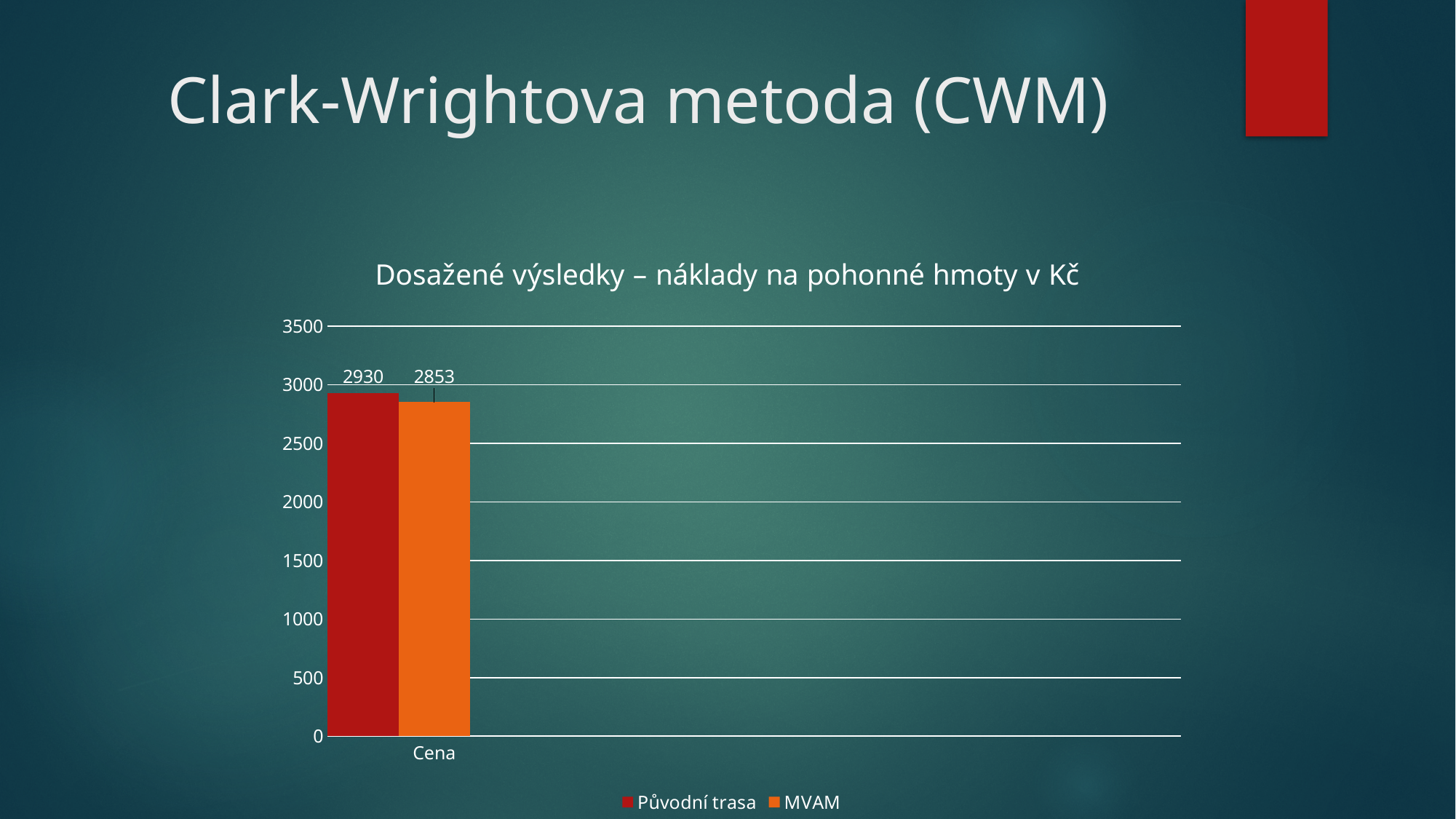
Is the value for Původní trasa greater or less than 2500? greater Which series has the higher value, Původní trasa or MVAM? Původní trasa Is the value for MVAM greater or less than 3000? less What is the label of the category on the x axis? Cena What is the title of the chart? Dosažené výsledky – náklady na pohonné hmoty v Kč What is the difference between the Původní trasa value and the MVAM value? 77 Which series has the lowest value in the chart? MVAM How many categories are shown on the x axis? 1 What is the value for MVAM in the chart? 2853 How many series does the legend list? 2 What kind of chart is shown on the slide? bar chart What is the value for Původní trasa in the chart? 2930